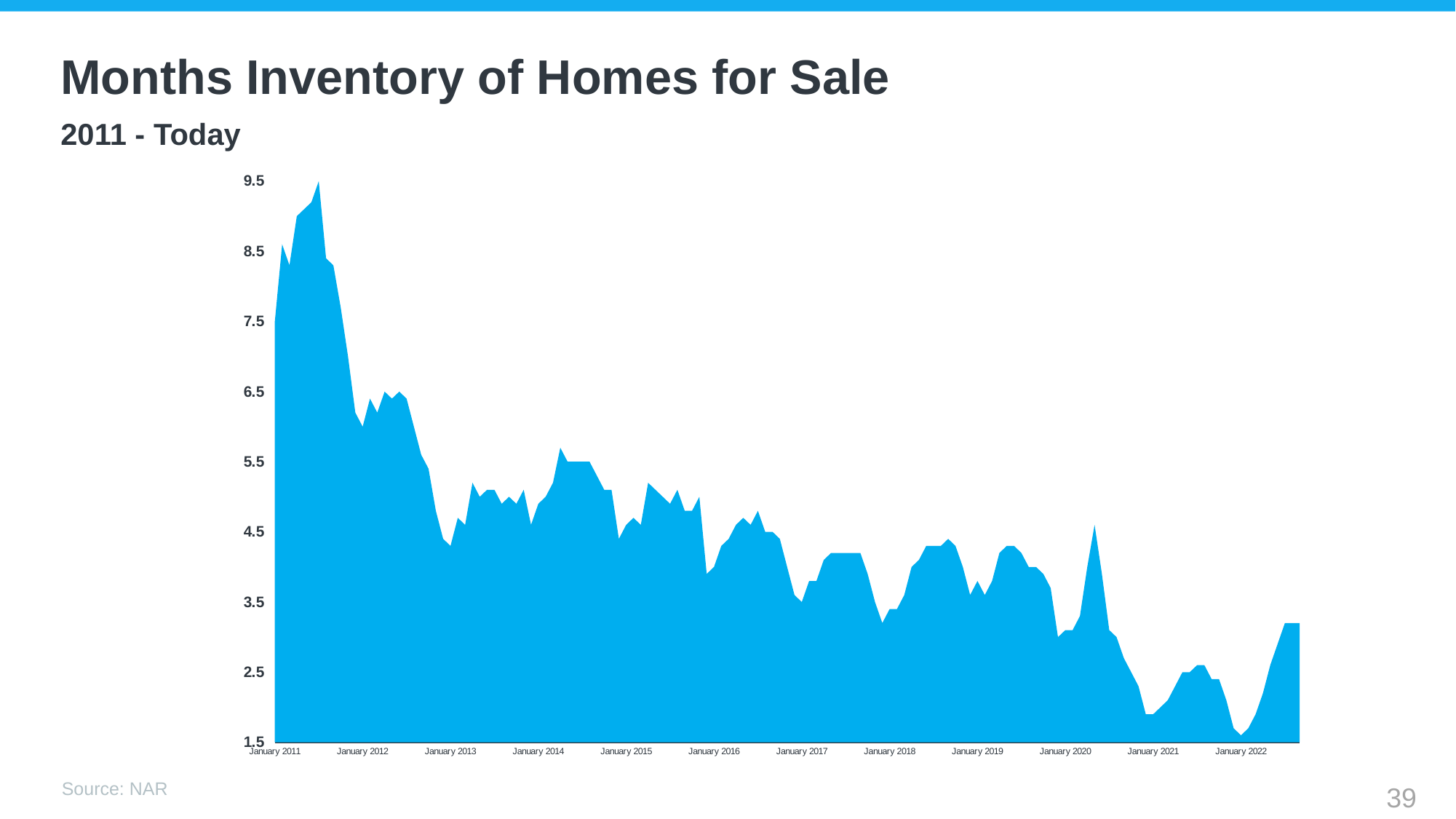
How many January labels are shown on the x axis? 12 What is the title of the chart? Months Inventory of Homes for Sale Is the peak value reached during 2011 greater or less than 8.5? greater Which is larger, the value at January 2012 or the value at January 2013? January 2012 Is the value at January 2022 greater or less than 2.5? less What kind of chart is shown on the slide? Area chart Overall, do the values rise or fall from January 2011 to January 2022? Fall Is the value at January 2013 greater or less than 5.5? less Which is larger, the value at January 2014 or the value at January 2021? January 2014 What source is cited for the chart? NAR